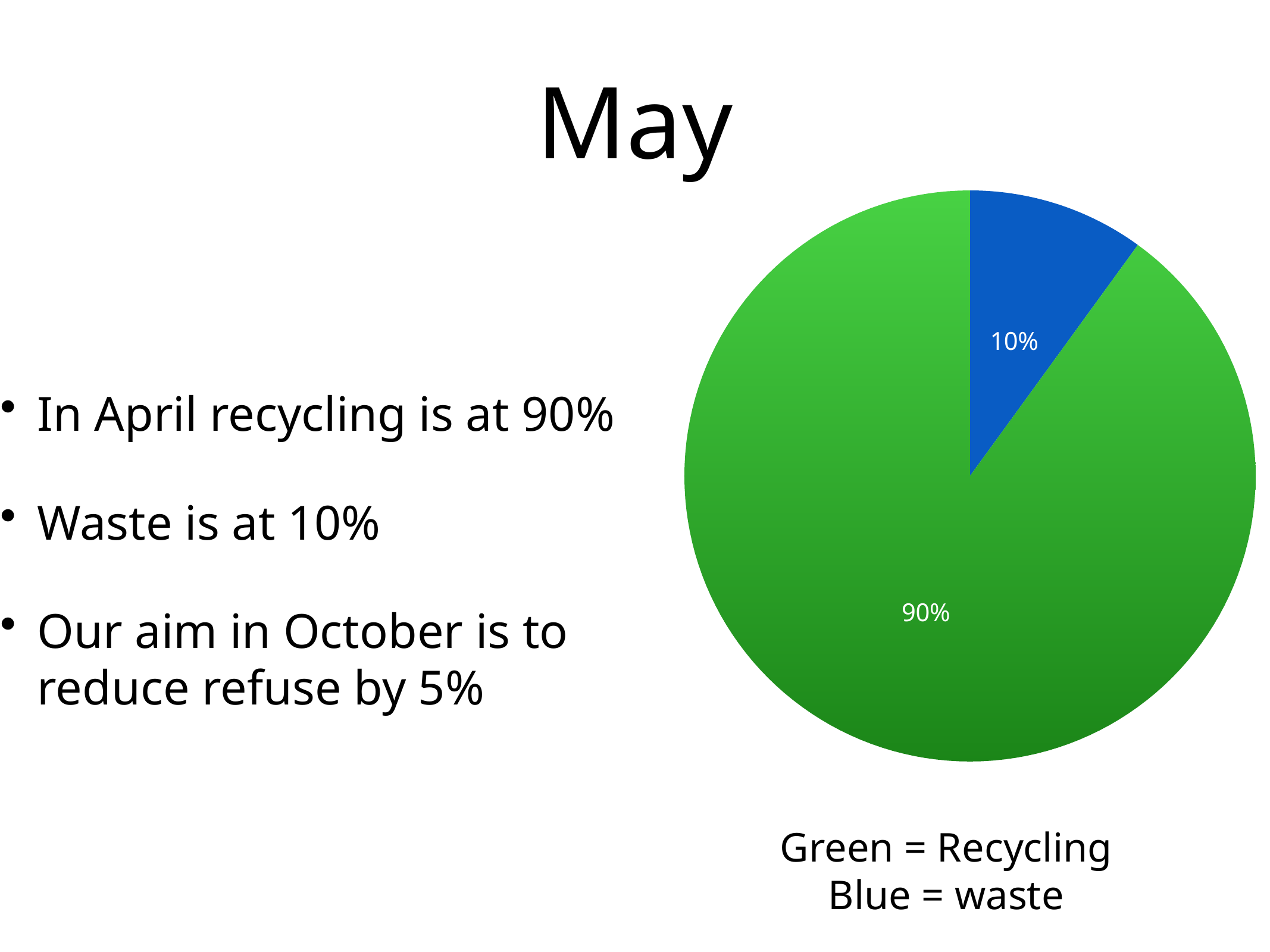
What is the difference between the Recycling share and the waste share? 80% What share of the pie does Recycling (green) take? 90% How many slices does the pie chart have? 2 What colour represents waste in the pie chart? Blue Which slice is the largest in the pie chart? Recycling What share of the pie does waste (blue) take? 10% What kind of chart is shown on the slide? pie chart Which is larger, the Recycling slice or the waste slice? Recycling What colour represents Recycling in the pie chart? Green Which slice is the smallest in the pie chart? waste